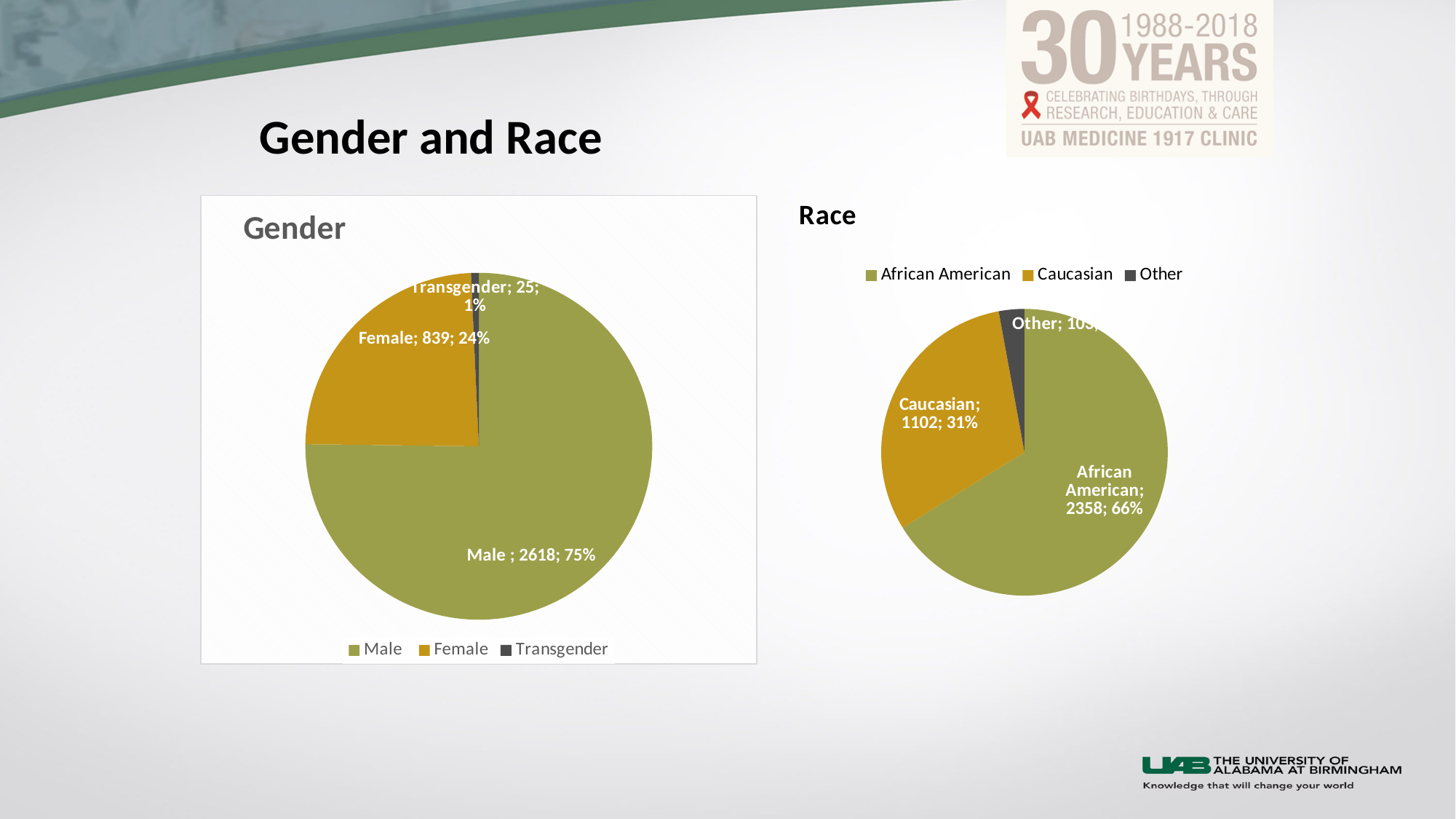
In the Gender chart, which category has the largest slice? Male In the Race chart, what percentage of the pie is African American? 66% In the Gender chart, what is the count for Transgender? 25 In the Gender chart, how many people are Male? 2618 What type of chart is the Gender chart? pie chart In the Gender chart, what is the difference between the Male and Female counts? 1779 In the Gender chart, which category has the smallest slice? Transgender In the Gender chart, what percentage of the pie is Female? 24% In the Race chart, which category has the largest slice? African American In the Race chart, how many people are Caucasian? 1102 How many categories does the legend of the Race chart list? 3 In the Race chart, is the African American count larger or smaller than the Caucasian count? larger